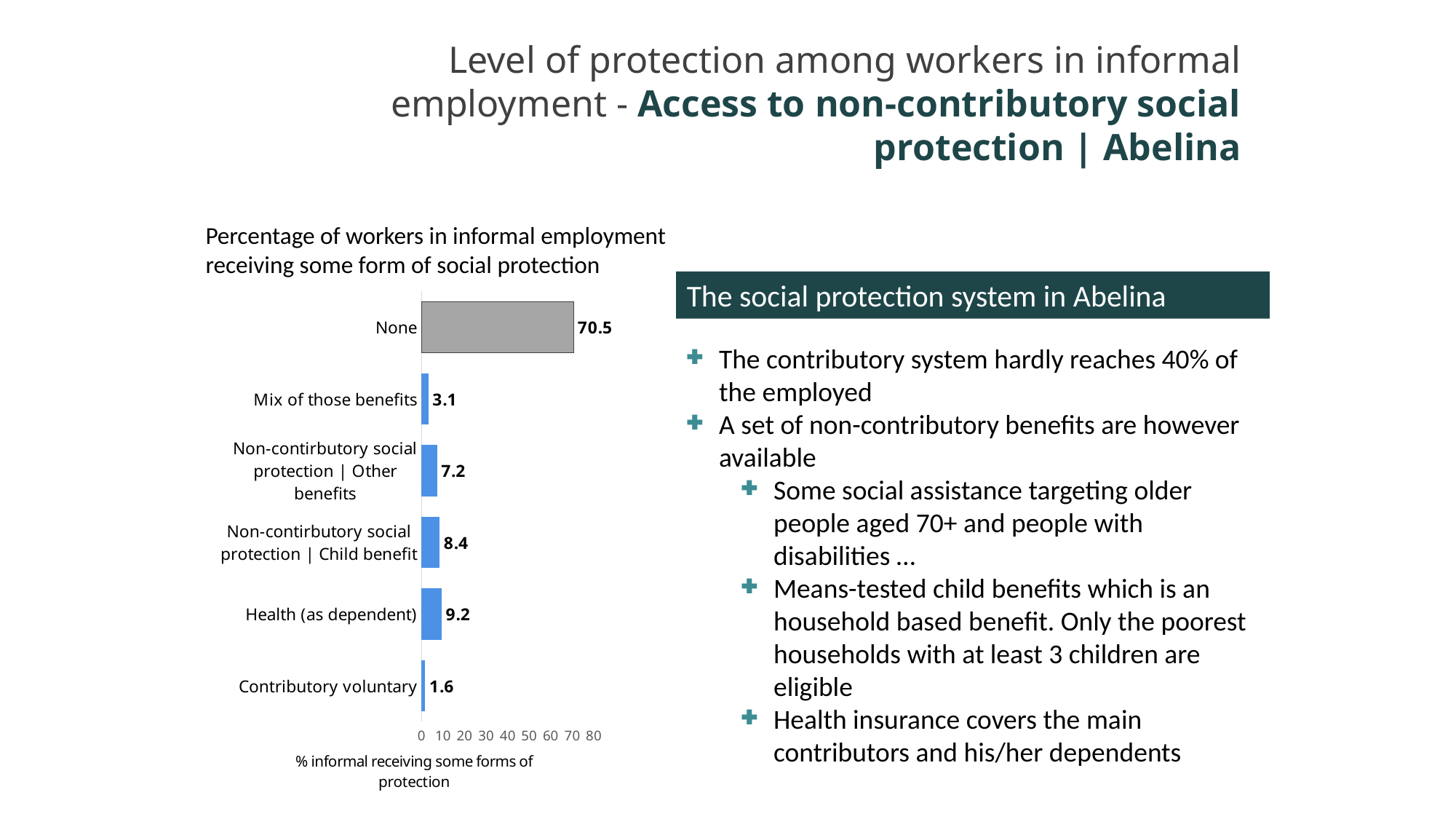
Which is larger, the value for Mix of those benefits or the value for Non-contirbutory social protection | Other benefits? Non-contirbutory social protection | Other benefits What is the value for None? 70.5 Which category has the highest value? None What is the value for Contributory voluntary? 1.6 Which category has the lowest value? Contributory voluntary What is the value for Health (as dependent)? 9.2 What is the difference between the values for None and Health (as dependent)? 61.3 Is the value for None greater or less than 60? greater What kind of chart is shown on the slide? bar chart How many categories are shown in the chart? 6 What is the value for Non-contirbutory social protection | Child benefit? 8.4 What is the label on the horizontal axis of the chart? % informal receiving some forms of protection